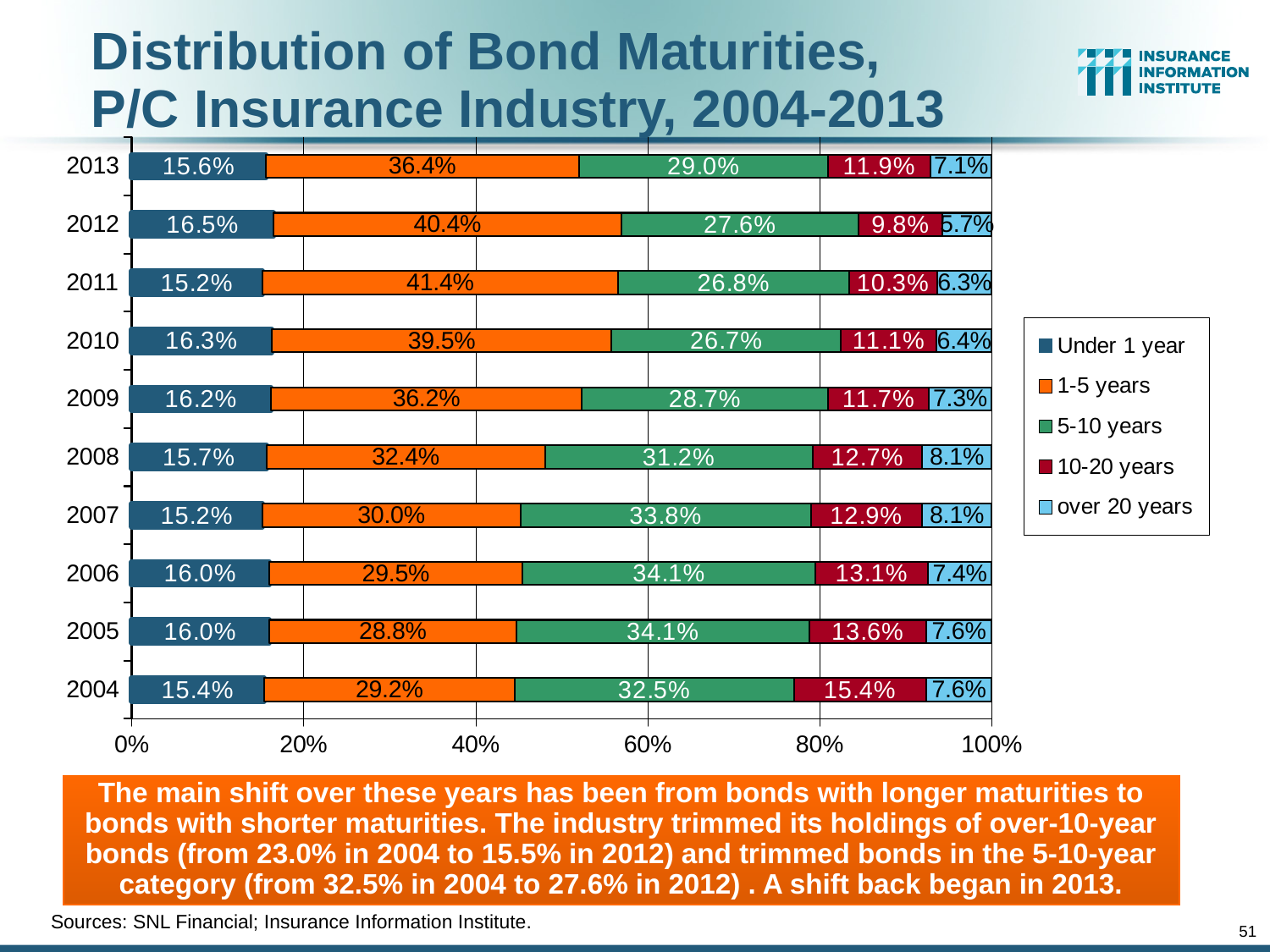
What was the share of bonds with maturities of 5-10 years in 2004? 32.5% In which year was the share of bonds with maturities over 20 years the lowest? 2012 Which maturity category is shown in orange in the chart? 1-5 years In which year was the share of 1-5 year bonds the highest? 2011 In which year was the share of 10-20 year bonds the highest? 2004 How many maturity categories does the legend list? 5 By how many percentage points did the share of 1-5 year bonds in 2013 exceed that in 2004? 7.2 percentage points How many years are shown in the chart? 10 What share of bonds had a maturity of 1-5 years in 2013? 36.4% Which year had a larger share of 5-10 year bonds, 2007 or 2013? 2007 What type of chart is used to show the distribution of bond maturities? Stacked bar chart What share of bonds had a maturity of over 20 years in 2008? 8.1%